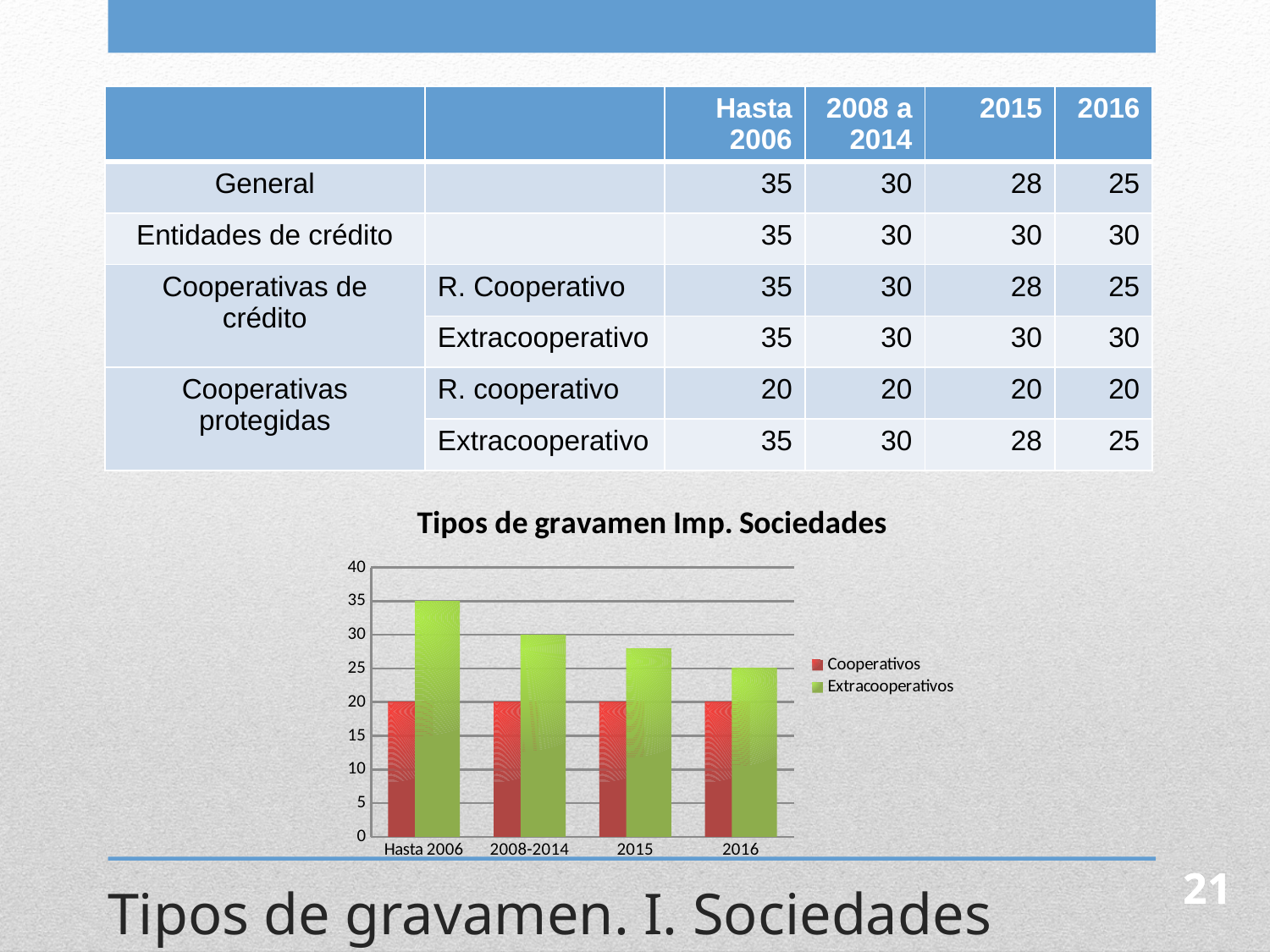
Is the value for Extracooperativos in 2015 greater or less than 25? greater What type of chart is shown on the slide? bar chart In which category is the Extracooperativos value highest? Hasta 2006 What is the difference between Extracooperativos and Cooperativos in Hasta 2006? 15 What is the value for Extracooperativos in 2008-2014? 30 In which category is the Extracooperativos value lowest? 2016 What is the value for Cooperativos in 2016? 20 How many series does the chart legend list? 2 What is the value for Extracooperativos in Hasta 2006? 35 How many categories are shown on the x axis of the chart? 4 Do the Extracooperativos values rise or fall from Hasta 2006 to 2016? fall What is the value for Extracooperativos in 2016? 25